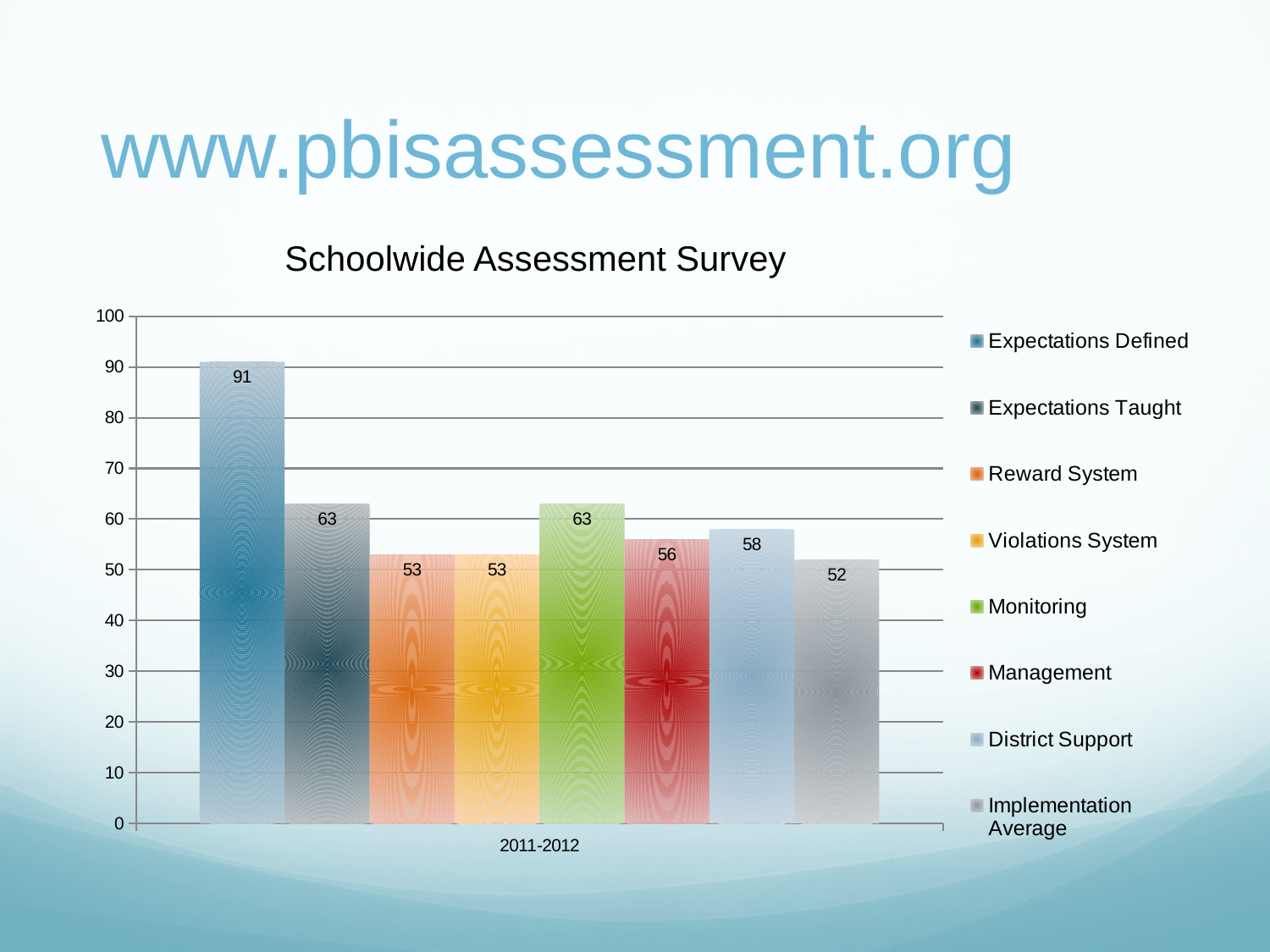
Which is larger, the value for District Support or the value for Management? District Support What is the value for Management in the Schoolwide Assessment Survey chart? 56 Which series has the lowest value in the Schoolwide Assessment Survey chart? Implementation Average How many series does the legend list in the Schoolwide Assessment Survey chart? 8 What kind of chart is the Schoolwide Assessment Survey? Bar chart What is the value for Expectations Defined in the Schoolwide Assessment Survey chart? 91 What is the difference between the values for Expectations Defined and Expectations Taught? 28 What is the value for Implementation Average in the Schoolwide Assessment Survey chart? 52 What is the x-axis label shown under the bars in the Schoolwide Assessment Survey chart? 2011-2012 What is the value for District Support in the Schoolwide Assessment Survey chart? 58 Is the value for Expectations Defined greater or less than 90? greater Which series has the highest value in the Schoolwide Assessment Survey chart? Expectations Defined